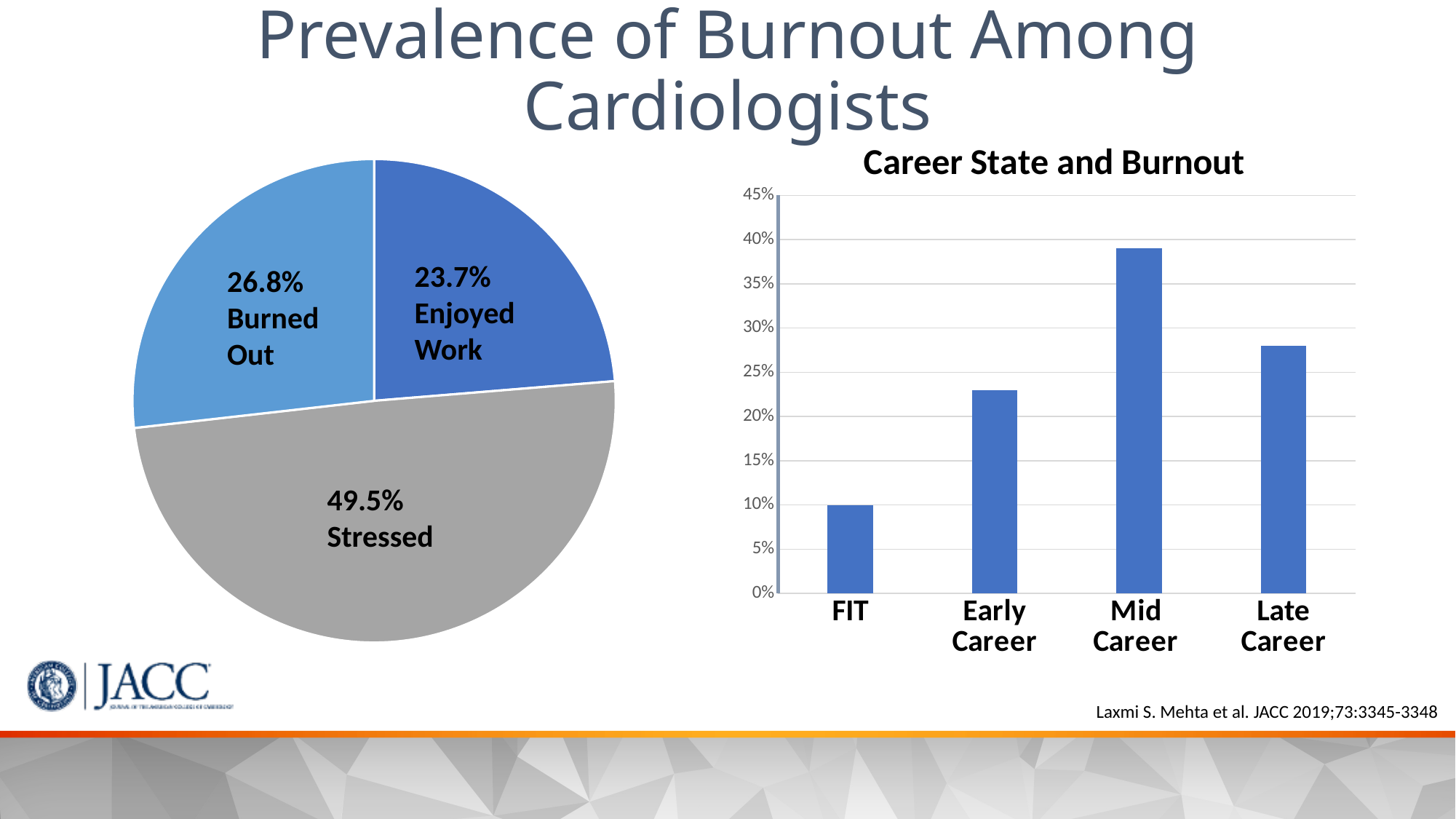
In the 'Career State and Burnout' chart, which career stage has the highest burnout? Mid Career In the pie chart on the left, what percentage of cardiologists Enjoyed Work? 23.7% In the pie chart on the left, which category has the smallest share? Enjoyed Work In the pie chart on the left, which category has the largest share? Stressed In the pie chart on the left, what is the difference between the Stressed share and the Burned Out share? 22.7% In the 'Career State and Burnout' chart, is the value for Early Career greater or less than 25%? less In the pie chart on the left, what percentage of cardiologists were Burned Out? 26.8% In the 'Career State and Burnout' chart, is the value for Mid Career greater or less than 35%? greater In the pie chart on the left, how many slices are there? 3 In the pie chart on the left, what percentage of cardiologists were Stressed? 49.5% In the 'Career State and Burnout' chart, which career stage has the lowest burnout? FIT What kind of chart is 'Career State and Burnout'? Bar chart